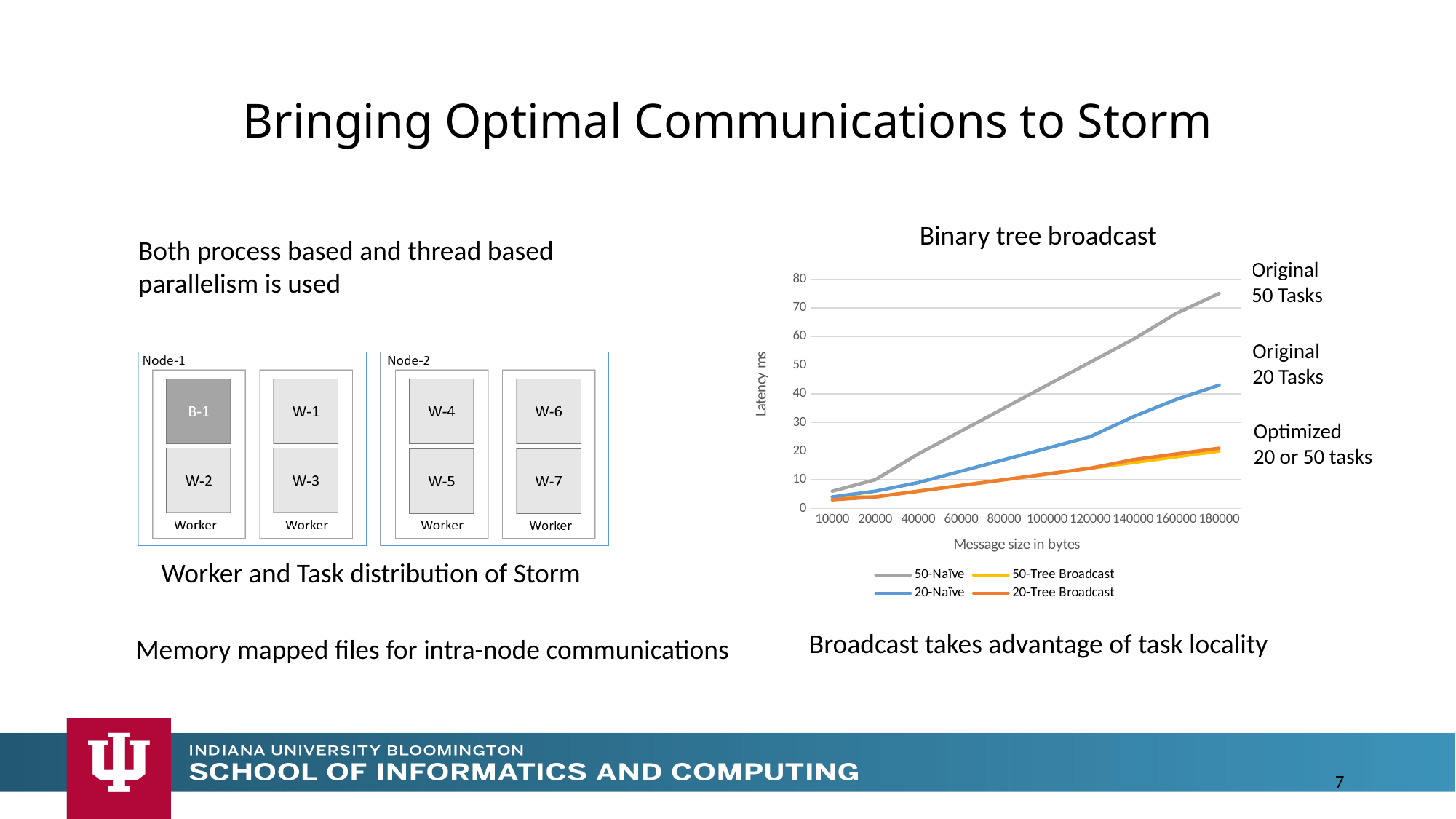
How many message-size points are shown on the x axis of the "Binary tree broadcast" chart? 10 At 100000 bytes, which has the lower latency: 20-Naïve or 20-Tree Broadcast? 20-Tree Broadcast What is the label of the y axis of the "Binary tree broadcast" chart? Latency ms How many series does the legend of the "Binary tree broadcast" chart list? 4 Which series has the highest latency at a message size of 180000 bytes? 50-Naïve What is the label of the x axis of the "Binary tree broadcast" chart? Message size in bytes Is the latency of the 20-Naïve series at 180000 bytes greater or less than 50? less What kind of chart is the "Binary tree broadcast" chart? line chart Is the latency of the 20-Tree Broadcast series at 180000 bytes greater or less than 30? less At 120000 bytes, which has the higher latency: 50-Naïve or 20-Naïve? 50-Naïve Does the latency of the 50-Naïve series rise or fall as message size increases? rise Is the latency of the 50-Naïve series at 180000 bytes greater or less than 70? greater